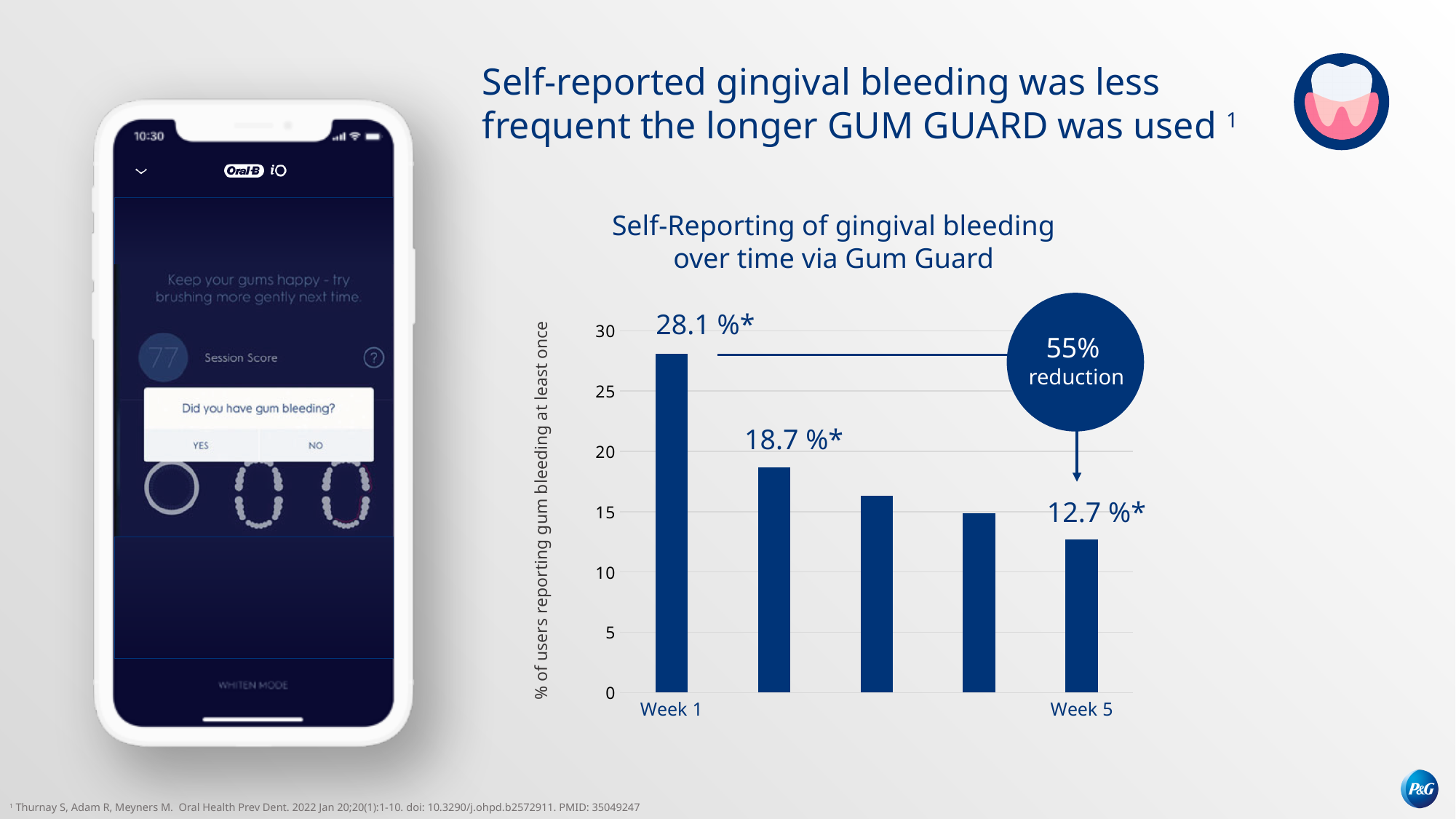
What reduction does the circle callout on the chart state? 55% reduction What kind of chart is shown on the slide? bar chart What value is labelled on the second bar from the left? 18.7 %* Do the values rise or fall from Week 1 to Week 5? fall Which week has the lowest percentage of users reporting gum bleeding? Week 5 What is the value for Week 5? 12.7 %* How many bars are plotted in the chart? 5 Which week has the highest percentage of users reporting gum bleeding? Week 1 What is the value for Week 1? 28.1 %* Which is larger, the value for Week 1 or the value for Week 5? Week 1 Is the value of the third bar from the left greater or less than 15? greater What is the title of the chart? Self-Reporting of gingival bleeding over time via Gum Guard